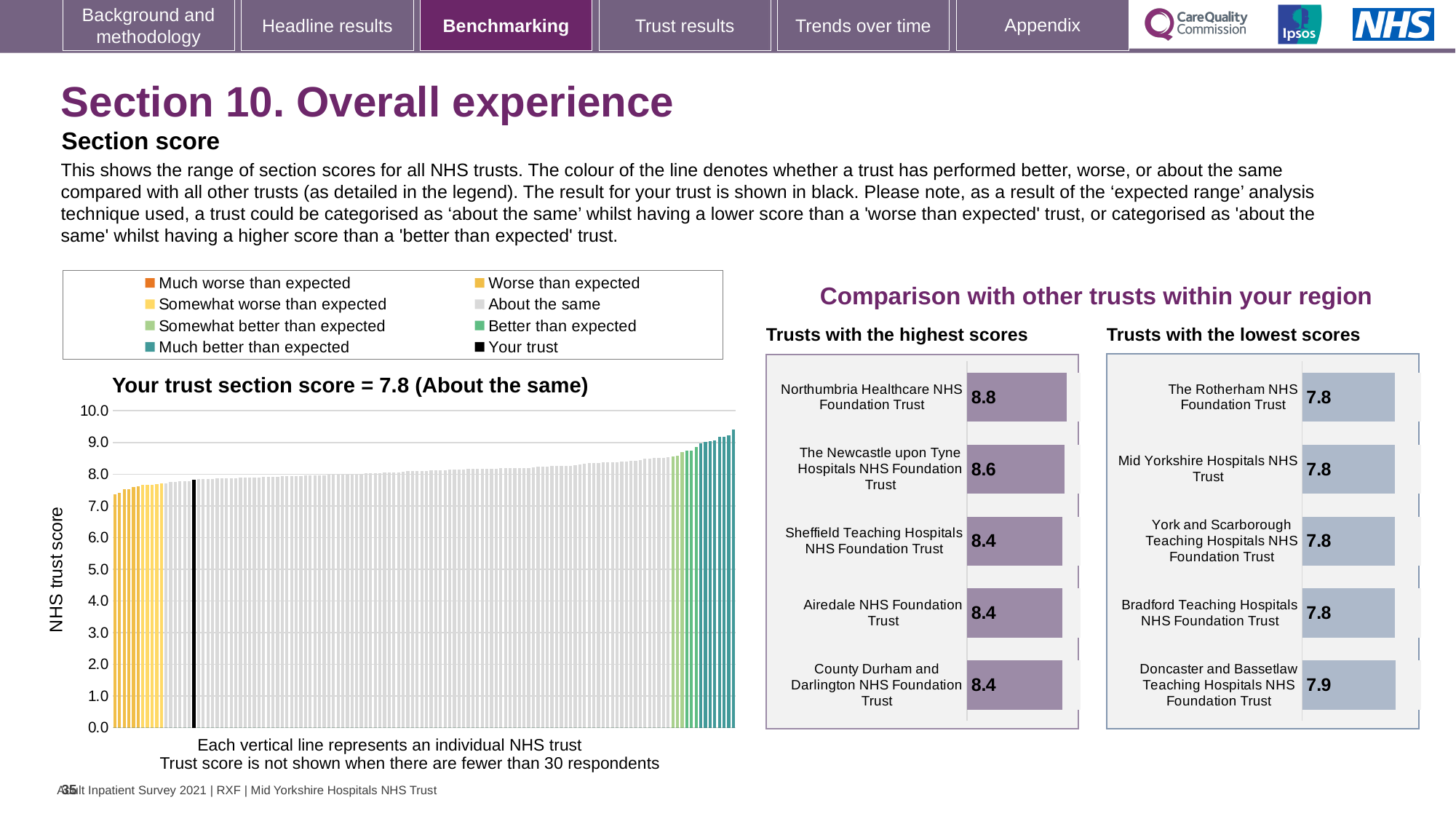
On the 'Your trust section score' chart, is the value of the rightmost (highest) bar greater or less than 9.0? greater On the 'Trusts with the lowest scores' chart, what is the score for Doncaster and Bassetlaw Teaching Hospitals NHS Foundation Trust? 7.9 On the 'Trusts with the highest scores' chart, how many trusts are listed? 5 On the 'Your trust section score' chart, how many entries does the legend list? 8 On the 'Your trust section score' chart, do the trust scores rise or fall from left to right along the x axis? Rise On the 'Trusts with the highest scores' chart, what is the score for The Newcastle upon Tyne Hospitals NHS Foundation Trust? 8.6 On the 'Trusts with the highest scores' chart, which trust has the highest score? Northumbria Healthcare NHS Foundation Trust On the 'Trusts with the lowest scores' chart, which is larger: the score for Doncaster and Bassetlaw Teaching Hospitals NHS Foundation Trust or the score for The Rotherham NHS Foundation Trust? Doncaster and Bassetlaw Teaching Hospitals NHS Foundation Trust On the 'Your trust section score' chart, what is the section score for your trust? 7.8 On the 'Your trust section score' chart, what kind of chart is shown? Bar chart On the 'Your trust section score' chart, what is the label of the y axis? NHS trust score On the 'Trusts with the highest scores' chart, what is the difference between the scores of Northumbria Healthcare NHS Foundation Trust and Airedale NHS Foundation Trust? 0.4